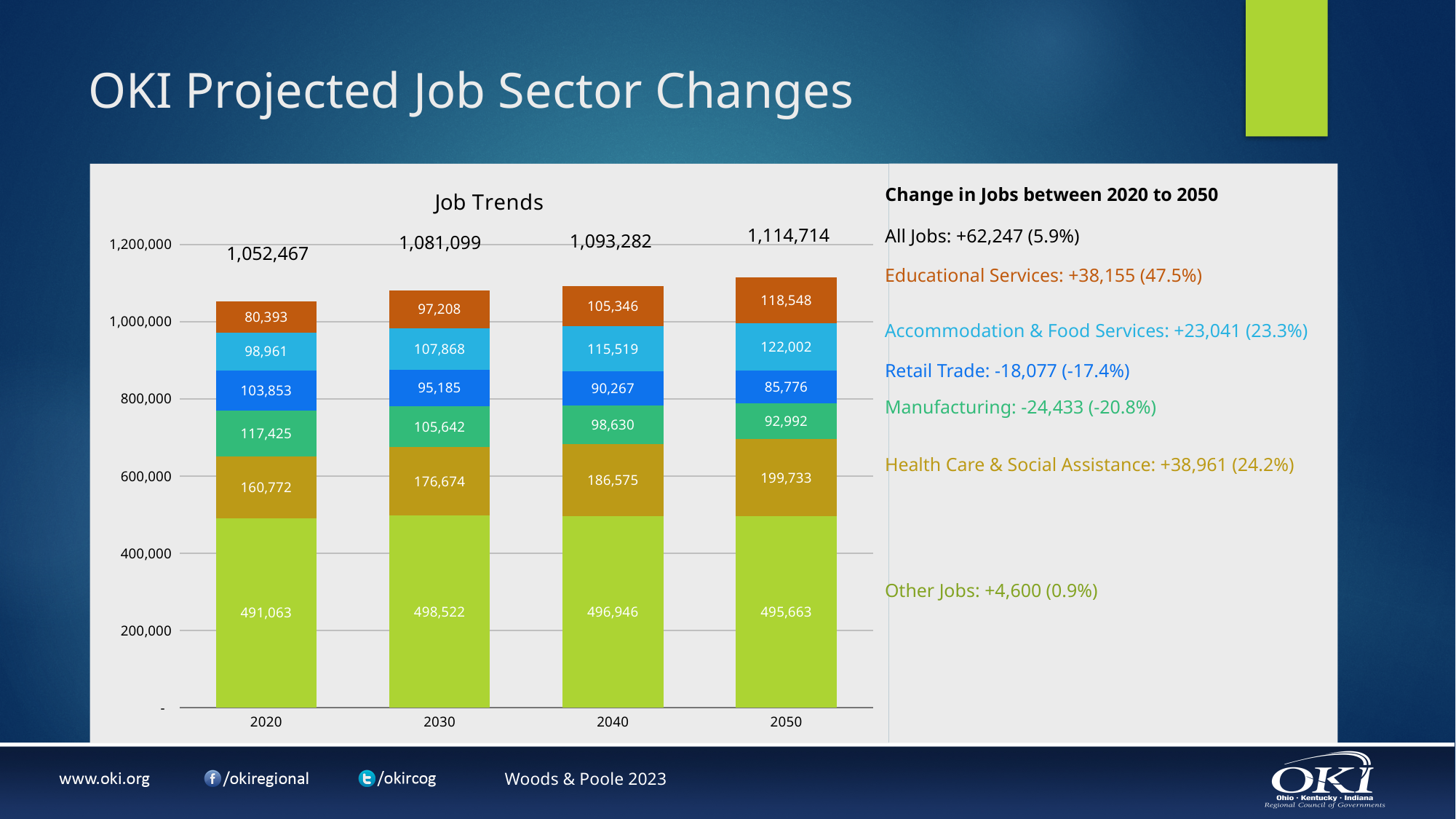
What is the total number of jobs shown above the 2020 bar in the Job Trends chart? 1,052,467 How many segments (job sectors) make up each bar in the Job Trends chart? 6 Which year has the lowest total jobs in the Job Trends chart? 2020 Do the total jobs rise or fall from 2020 to 2050 in the Job Trends chart? rise What is the value of the top (orange, Educational Services) segment of the 2040 bar? 105,346 What kind of chart is the Job Trends chart? stacked bar chart Which year has the highest total jobs in the Job Trends chart? 2050 What is the total number of jobs shown above the 2050 bar in the Job Trends chart? 1,114,714 What is the difference between the total jobs in 2050 and in 2020 in the Job Trends chart? 62,247 How many years (bars) are shown in the Job Trends chart? 4 What is the value of the bottom (lime green, Other Jobs) segment of the 2030 bar? 498,522 In the 2050 bar, which is larger: the gold Health Care & Social Assistance segment (199,733) or the green Manufacturing segment (92,992)? Health Care & Social Assistance